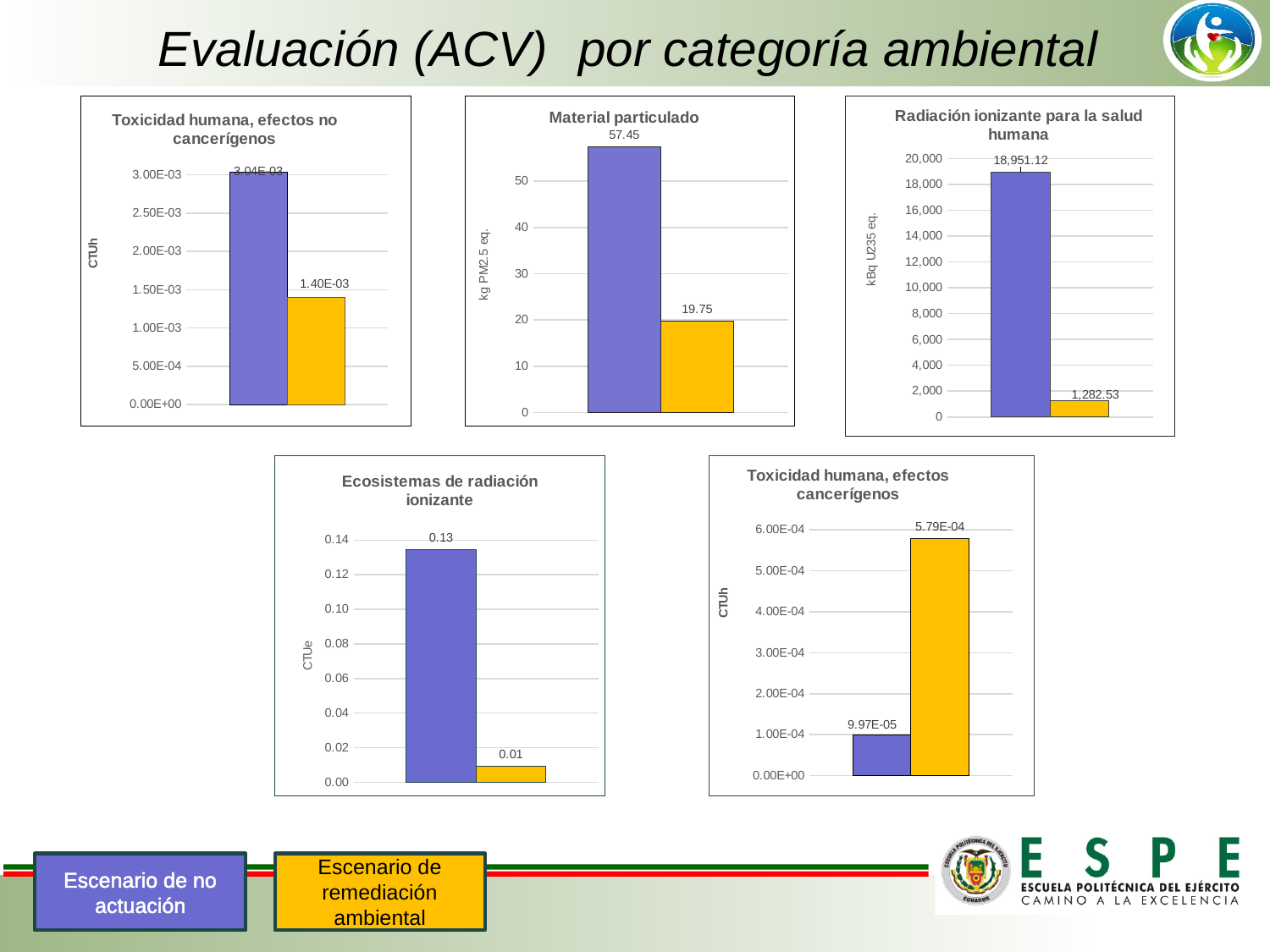
In the 'Ecosistemas de radiación ionizante' chart, which scenario has the higher value? Escenario de no actuación What kind of chart is 'Radiación ionizante para la salud humana'? Bar chart In the 'Radiación ionizante para la salud humana' chart, what is the value for the 'Escenario de remediación ambiental' bar? 1,282.53 In the 'Radiación ionizante para la salud humana' chart, what is the value for the 'Escenario de no actuación' bar? 18,951.12 In the 'Material particulado' chart, what is the value for the 'Escenario de no actuación' (blue) bar? 57.45 What is the y-axis unit label on the 'Material particulado' chart? kg PM2.5 eq. In the 'Material particulado' chart, what is the difference between the 'Escenario de no actuación' and 'Escenario de remediación ambiental' values? 37.70 In the 'Toxicidad humana, efectos cancerígenos' chart, what is the value for the 'Escenario de remediación ambiental' bar? 5.79E-04 In the 'Toxicidad humana, efectos no cancerígenos' chart, what is the value for the 'Escenario de remediación ambiental' bar? 1.40E-03 In the 'Material particulado' chart, what is the value for the 'Escenario de remediación ambiental' (yellow) bar? 19.75 In the 'Toxicidad humana, efectos cancerígenos' chart, which scenario has the lower value? Escenario de no actuación In the 'Ecosistemas de radiación ionizante' chart, is the value for 'Escenario de no actuación' greater or less than 0.10? greater